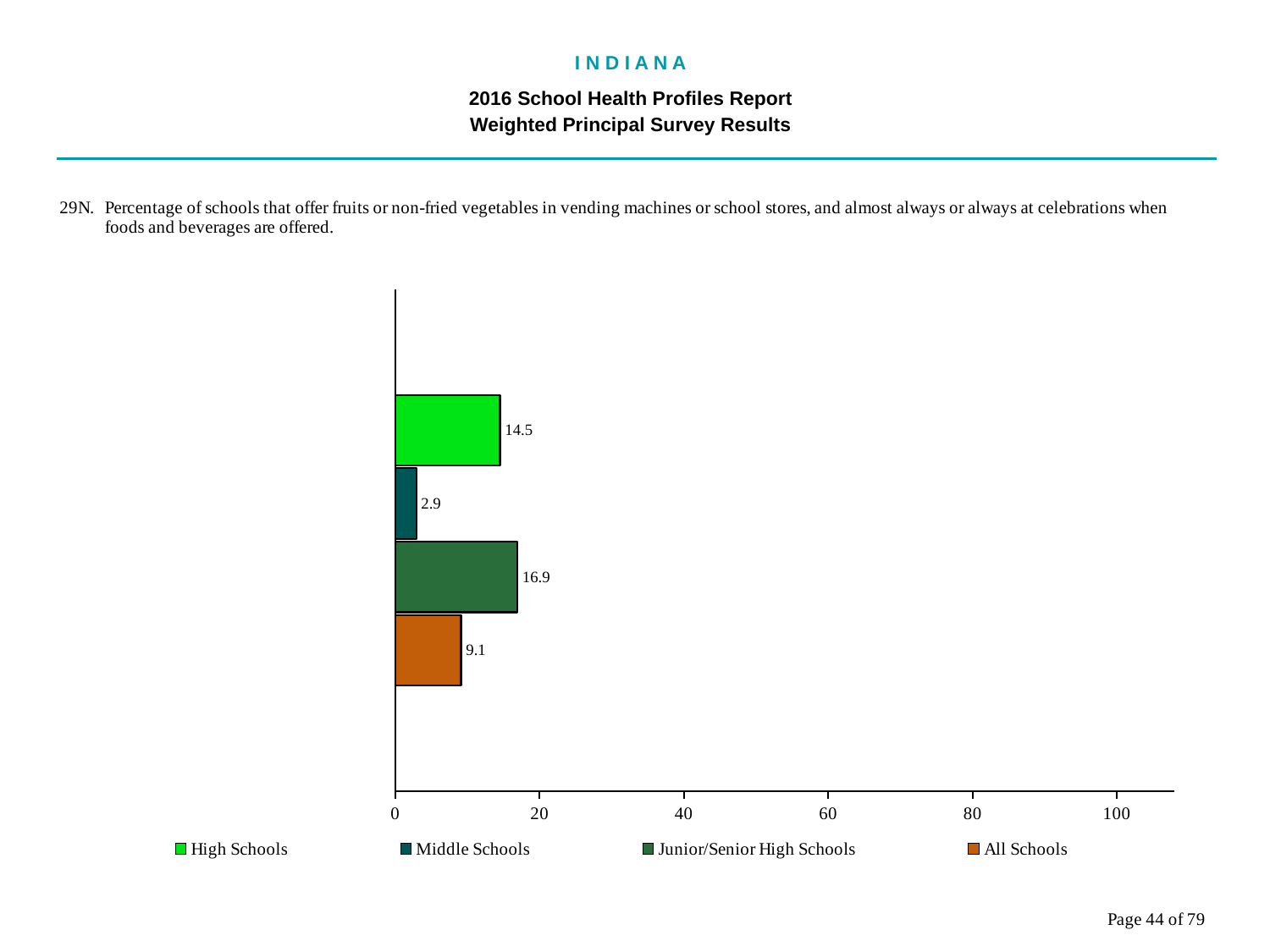
What is the difference between the values for Junior/Senior High Schools and High Schools? 2.4 Is the value for Junior/Senior High Schools greater or less than 20? less What is the difference between the values for High Schools and Middle Schools? 11.6 What is the value for High Schools? 14.5 What is the value for Junior/Senior High Schools? 16.9 What is the value for All Schools? 9.1 What is the value for Middle Schools? 2.9 What kind of chart is shown on the slide? bar chart Which is larger, the value for All Schools or the value for Middle Schools? All Schools How many series does the legend list? 4 Which school type has the highest value? Junior/Senior High Schools Which school type has the lowest value? Middle Schools